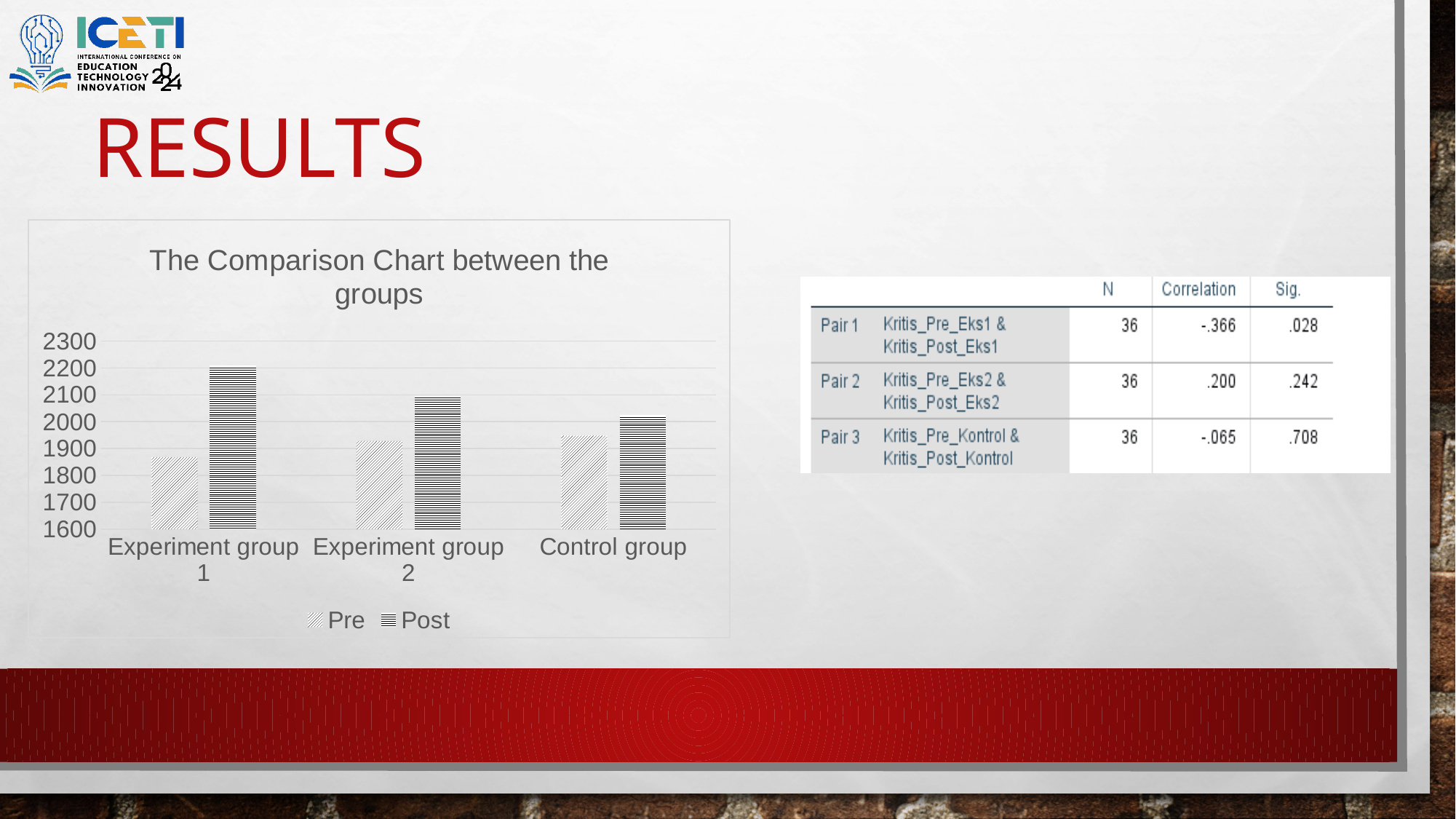
How many groups (categories) are shown on the x axis of the chart? 3 What kind of chart is shown on the slide? bar chart How many series does the chart's legend list? 2 Which is larger, the Post value for Experiment group 1 or the Post value for the Control group? Experiment group 1 Is the Post value for the Control group greater or less than 2100? less Which group has the highest Post value? Experiment group 1 For Experiment group 2, which is larger, the Pre value or the Post value? Post Is the Pre value for the Control group greater or less than 2000? less Is the Post value for Experiment group 1 greater or less than 2100? greater What is the title of the chart? The Comparison Chart between the groups Which group has the lowest Pre value? Experiment group 1